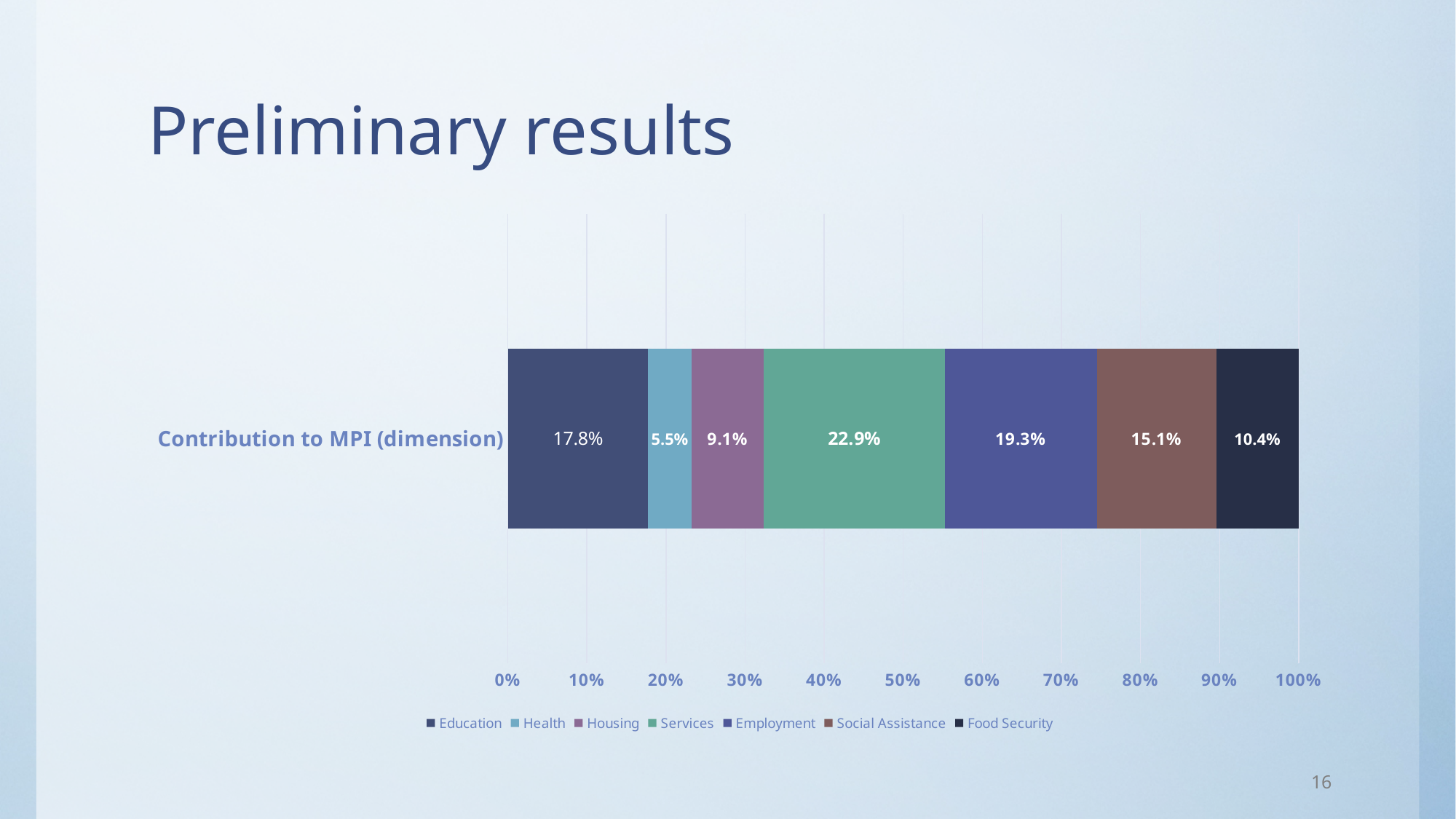
Which dimension has the smallest contribution to the MPI? Health What is the value for Education in the Contribution to MPI (dimension) bar? 17.8% How many series does the legend list? 7 What is the difference between the Employment value and the Education value? 1.5% Which dimension has the largest contribution to the MPI? Services What is the value for Social Assistance in the Contribution to MPI (dimension) bar? 15.1% What is the difference between the Services value and the Health value? 17.4% What is the value for Food Security in the Contribution to MPI (dimension) bar? 10.4% What kind of chart is shown on the slide? Stacked bar chart What is the label of the single category shown on the chart's vertical axis? Contribution to MPI (dimension) Which is larger, the value for Housing or the value for Food Security? Food Security What is the value for Services in the Contribution to MPI (dimension) bar? 22.9%